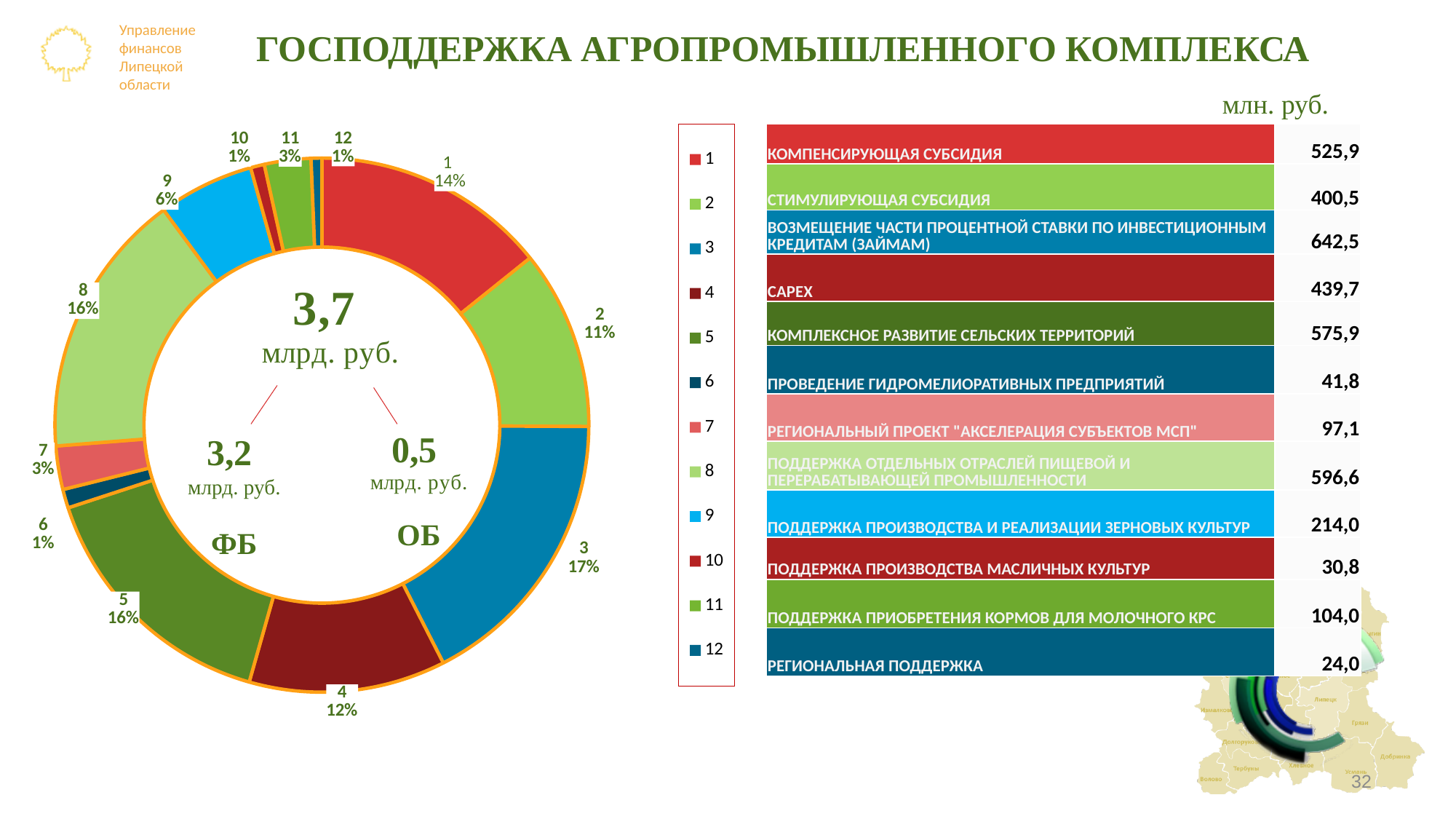
What percentage share does slice 3 have in the doughnut chart? 17% How many slices does the doughnut chart have? 12 Which slice has a larger share in the doughnut chart, slice 8 or slice 9? 8 What percentage share does slice 1 have in the doughnut chart? 14% What percentage share does slice 9 have in the doughnut chart? 6% Which slice has a larger share in the doughnut chart, slice 4 or slice 7? 4 What type of chart is shown on the left of the slide? Doughnut (pie) chart What percentage share does slice 8 have in the doughnut chart? 16% What total value is printed in the centre of the doughnut chart? 3,7 млрд. руб. What is the difference in percentage points between slice 3 and slice 2 in the doughnut chart? 6 Which slice has the largest share in the doughnut chart? 3 How many entries does the legend of the doughnut chart list? 12